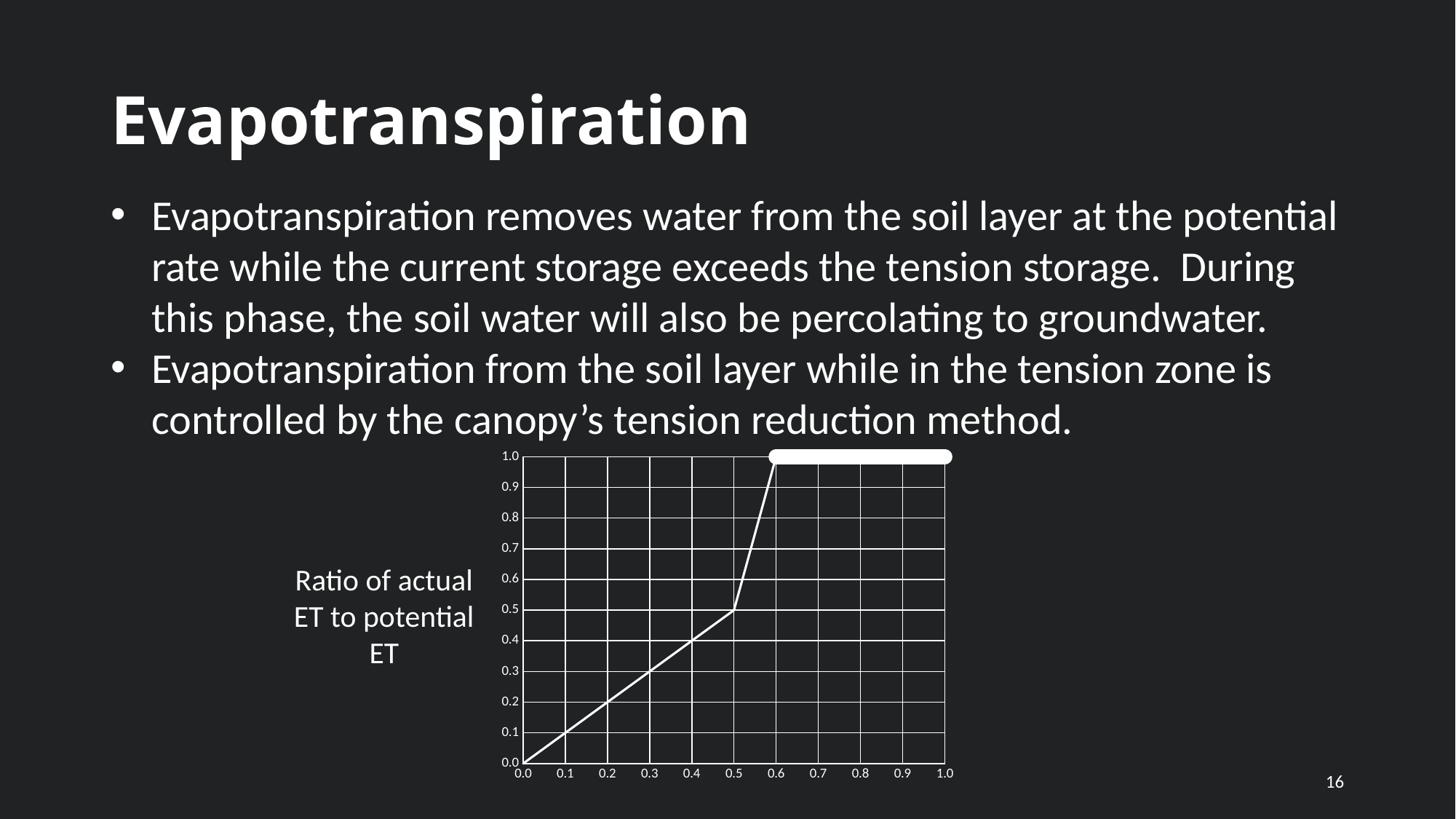
What is the highest value the line reaches on the vertical axis? 1.0 Is the value of the line at x = 0.8 greater or less than 0.5? greater What is the label on the vertical axis of the chart? Ratio of actual ET to potential ET Which is larger: the value of the line at x = 0.2 or at x = 0.8? x = 0.8 What is the value of the line at x = 1.0? 1.0 What is the value of the line at x = 0.0? 0.0 What is the largest tick value shown on the horizontal axis? 1.0 What kind of chart is shown on the slide? line chart What is the value of the line at x = 0.5? 0.5 Is the value of the line at x = 0.3 greater or less than 0.5? less Does the plotted line rise or fall as the x value increases from 0.0 to 0.6? rises What is the value of the line at x = 0.6? 1.0